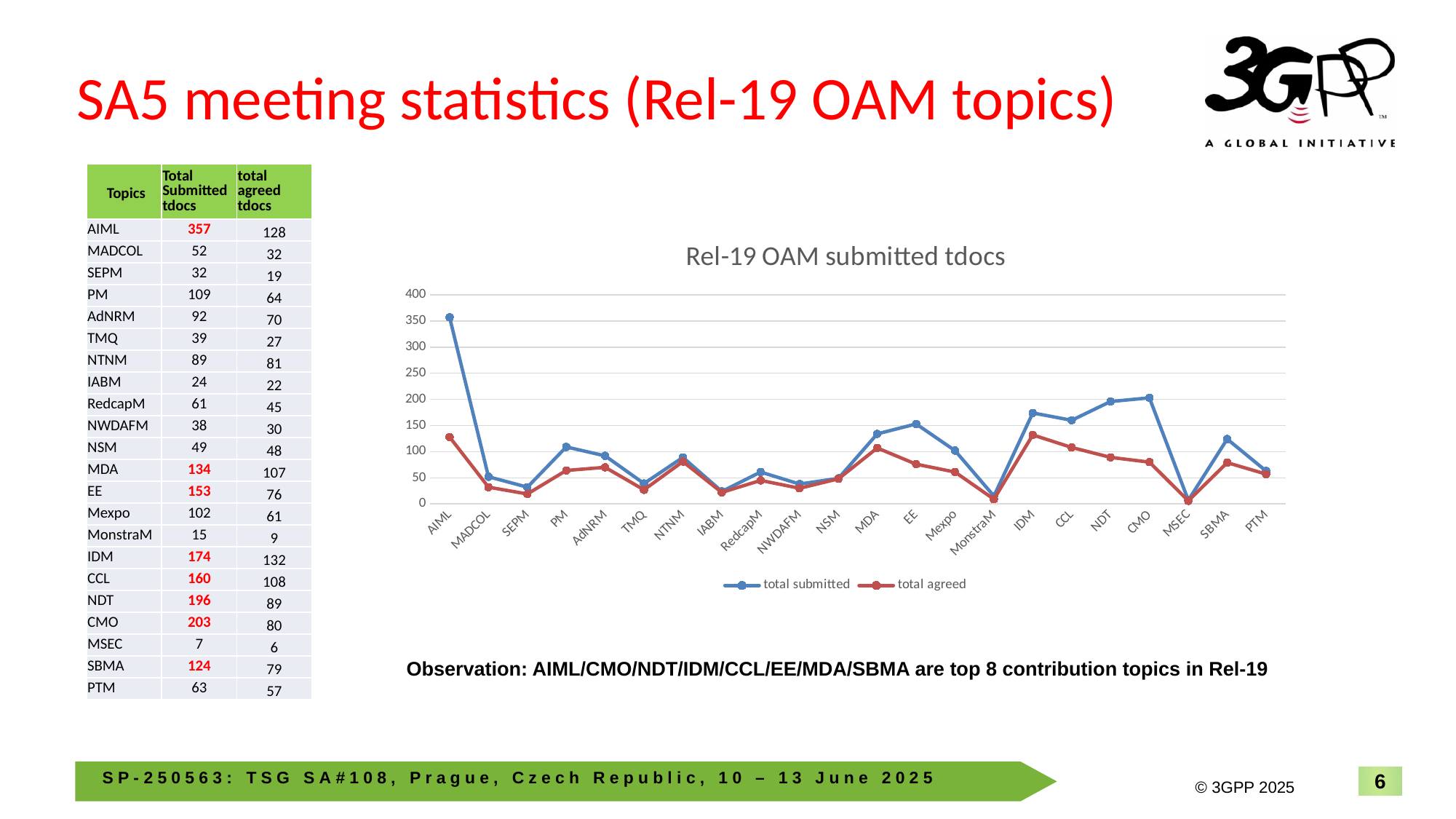
What is the total submitted tdocs value for CMO? 203 Which topic has the highest total submitted tdocs? AIML How many topics are plotted along the x axis of the chart? 22 Is the total agreed value for MonstraM greater or less than 50? less What is the title of the chart? Rel-19 OAM submitted tdocs Which is larger, total submitted tdocs for IDM or for CCL? IDM Which topic has the lowest total submitted tdocs? MSEC What is the difference between total submitted and total agreed tdocs for NDT? 107 What is the total agreed tdocs value for AIML? 128 Is the total submitted value for AIML greater or less than 300? greater What type of chart is shown on the slide? line chart How many series does the chart legend list? 2